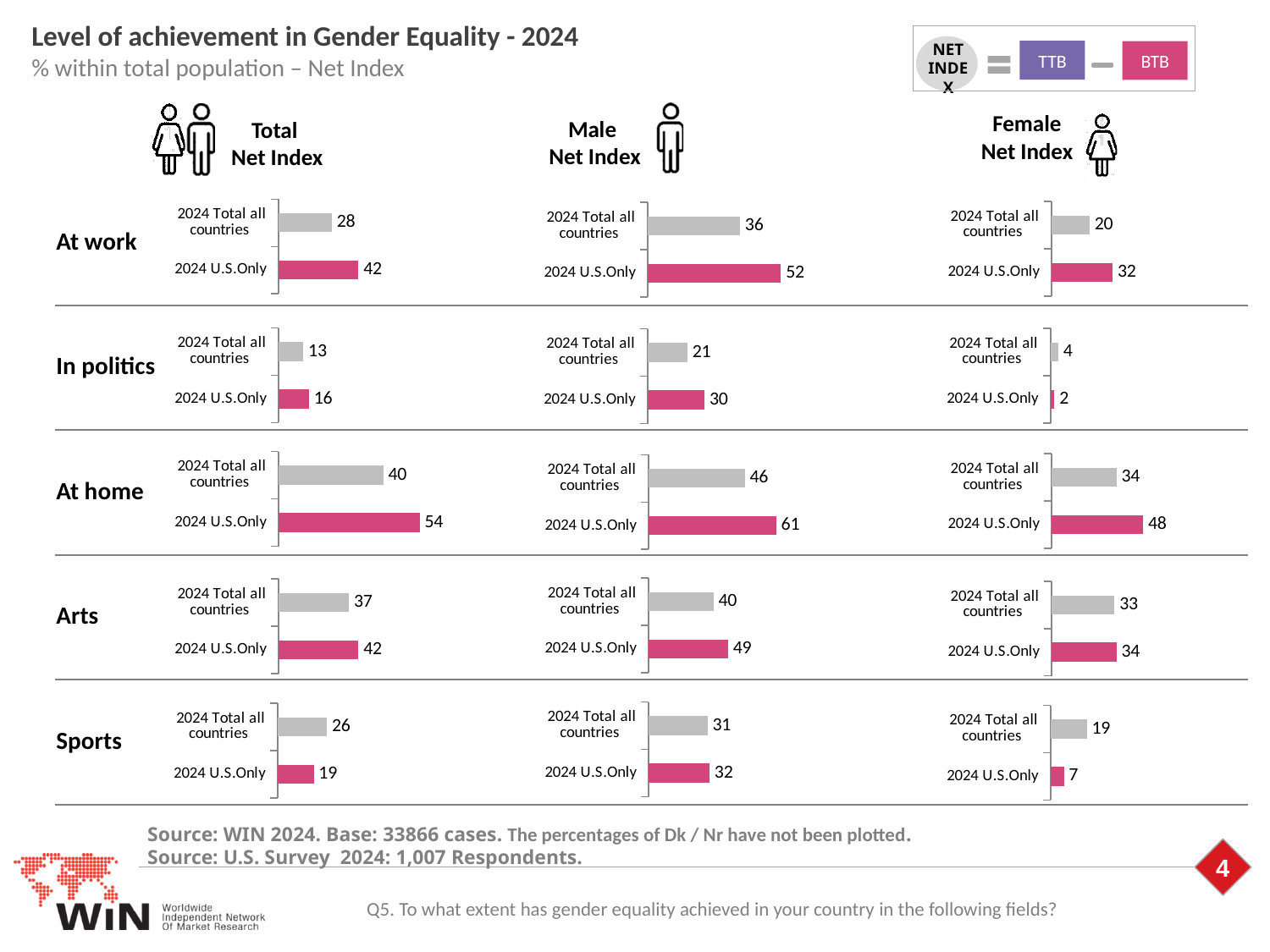
In the Sports row, Female Net Index chart, what is the value for 2024 U.S.Only? 7 In the In politics row, Female Net Index chart, what is the value for 2024 Total all countries? 4 In the Arts row, Male Net Index chart, which is larger: 2024 Total all countries or 2024 U.S.Only? 2024 U.S.Only In the Sports row, Male Net Index chart, what is the value for 2024 Total all countries? 31 In the Sports row, Total Net Index chart, which is larger: 2024 Total all countries or 2024 U.S.Only? 2024 Total all countries In the At work row, Male Net Index chart, how many bars are plotted? 2 In the At home row, Male Net Index chart, what is the value for 2024 U.S.Only? 61 In the In politics row, Male Net Index chart, what is the difference between the 2024 U.S.Only value and the 2024 Total all countries value? 9 In the At home row, Total Net Index chart, what is the difference between the 2024 U.S.Only value and the 2024 Total all countries value? 14 What kind of chart is used in the Arts row, Female Net Index chart? Bar chart In the At work row, Total Net Index chart, what is the value for 2024 U.S.Only? 42 What is the title of the slide? Level of achievement in Gender Equality - 2024